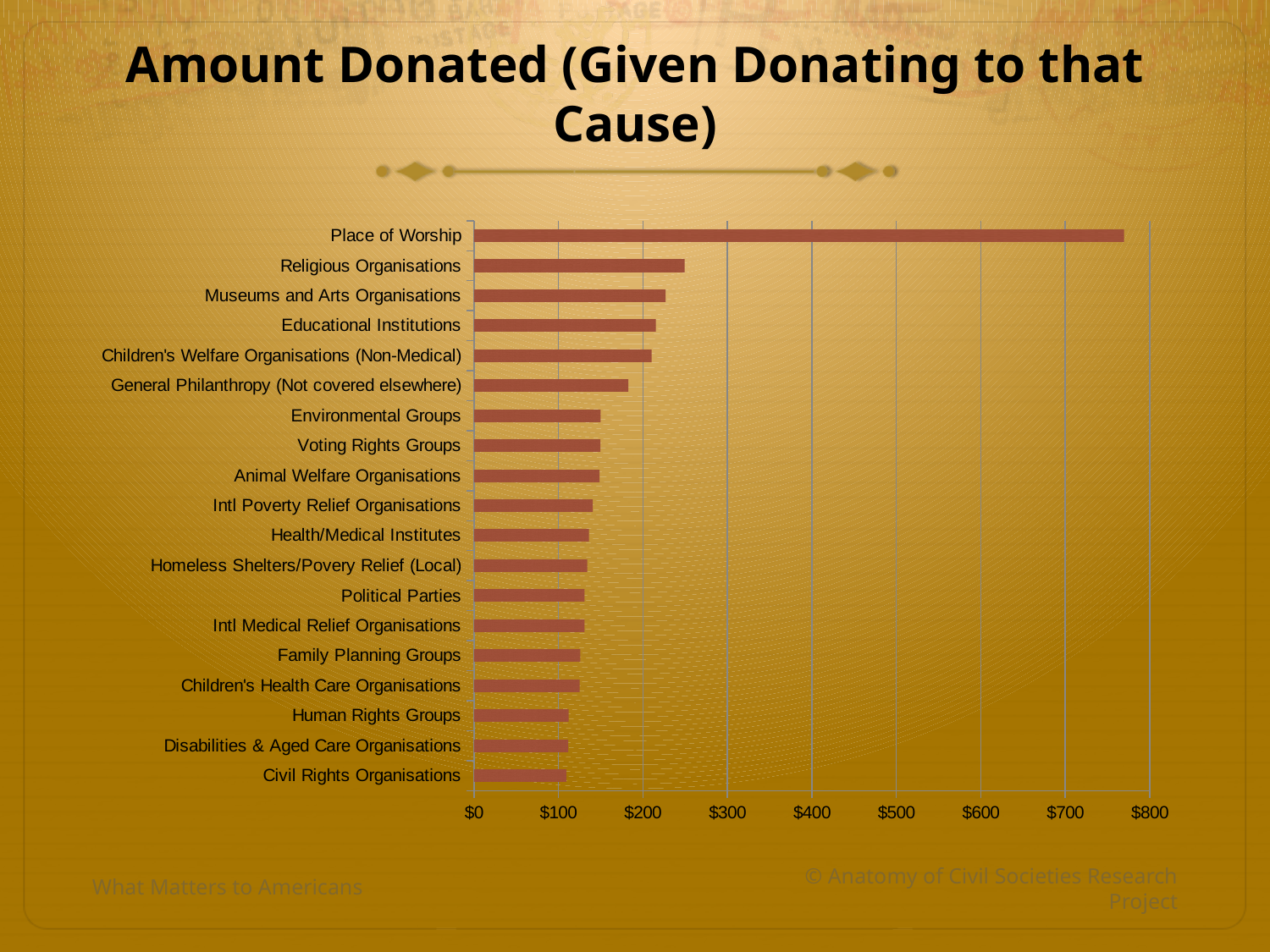
Is the value for Environmental Groups greater or less than $100? greater Which is larger, the amount donated to Religious Organisations or to Environmental Groups? Religious Organisations Which cause has the highest amount donated? Place of Worship Is the value for Political Parties greater or less than $200? less Is the value for General Philanthropy (Not covered elsewhere) greater or less than $200? less What is the title of the chart? Amount Donated (Given Donating to that Cause) What kind of chart is shown on the slide? bar chart Which is larger, the amount donated to Place of Worship or to Religious Organisations? Place of Worship How many causes (categories) are plotted in the chart? 19 What is the highest value shown on the horizontal axis? $800